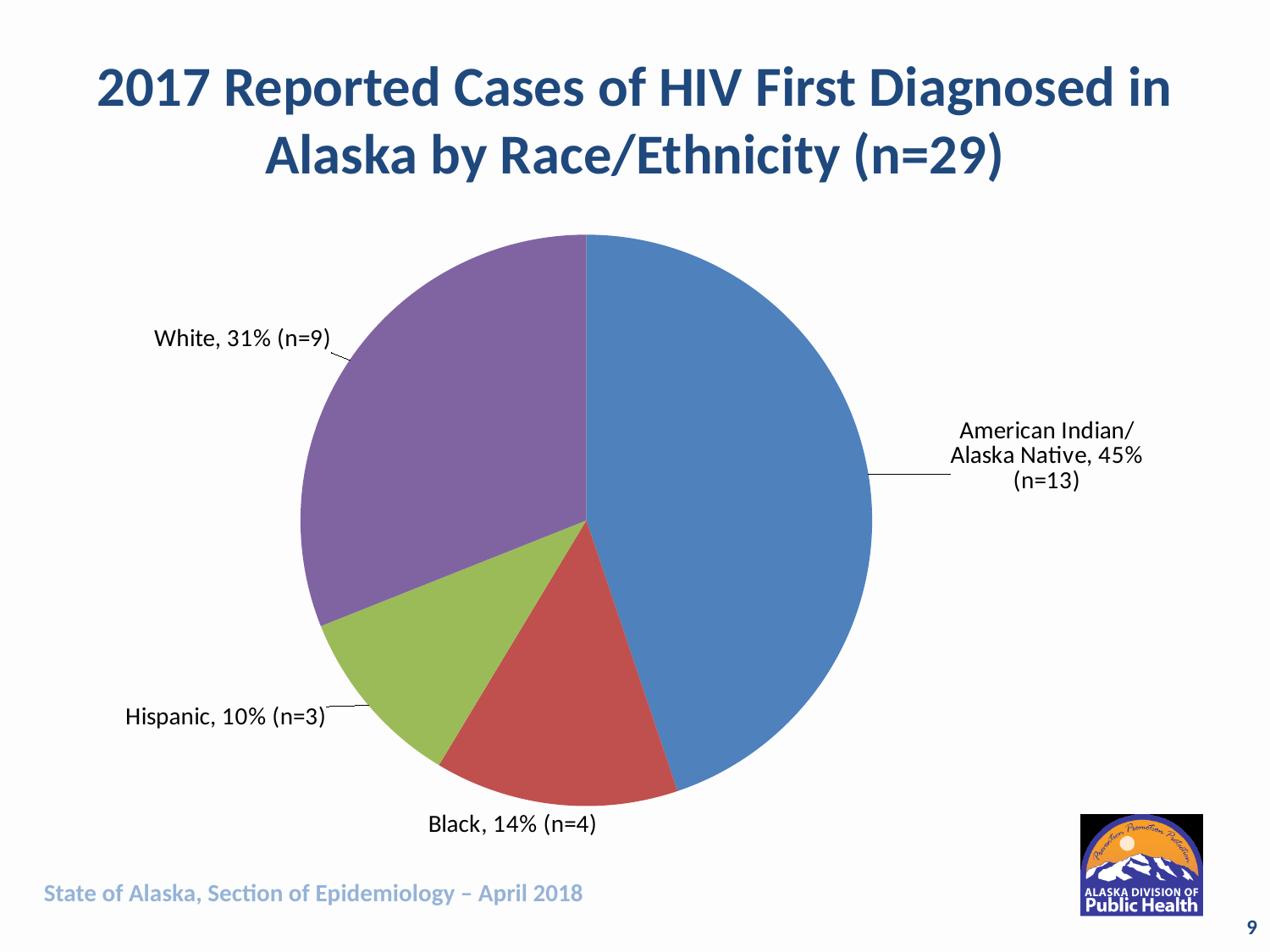
What kind of chart is shown on the slide? pie chart Which race/ethnicity group has the smallest share of cases? Hispanic What percentage of cases were among American Indian/Alaska Native people? 45% How many race/ethnicity categories are shown in the pie chart? 4 Which group has more cases, Black or Hispanic? Black What is the difference in percentage points between the Black and Hispanic slices? 4 Which race/ethnicity group has the largest share of cases? American Indian/Alaska Native What is the difference in number of cases between American Indian/Alaska Native and White? 4 What percentage of cases were among Hispanic people? 10% What colour is the slice for White? purple How many cases (n) were reported among White people? 9 How many cases (n) were reported among Black people? 4